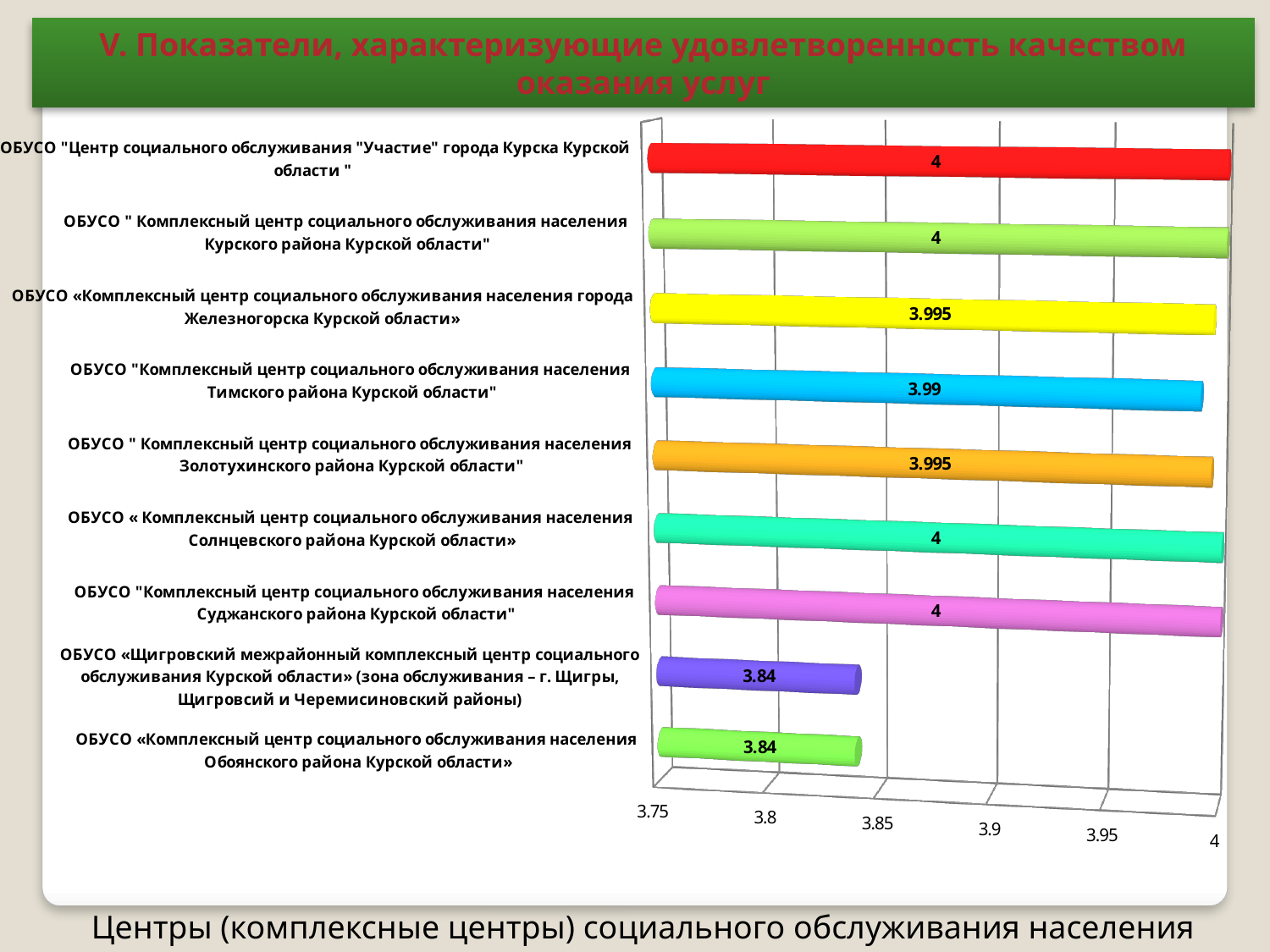
What kind of chart is shown on the slide? bar chart What is the difference between the value for the Тимского района centre and the value for the Щигровский межрайонный centre? 0.15 Which has the larger value: the Золотухинского района centre or the Тимского района centre? Золотухинского района centre What is the value for ОБУСО "Комплексный центр социального обслуживания населения Суджанского района Курской области"? 4 How many centres (categories) are plotted in the chart? 9 What is the value for ОБУСО "Комплексный центр социального обслуживания населения Тимского района Курской области"? 3.99 Is the value for the Щигровский межрайонный centre greater or less than 3.9? less What is the caption text shown below the chart? Центры (комплексные центры) социального обслуживания населения What is the value for ОБУСО «Комплексный центр социального обслуживания населения Обоянского района Курской области»? 3.84 What is the highest value shown in the chart? 4 What is the lowest value shown in the chart? 3.84 What is the value for ОБУСО «Комплексный центр социального обслуживания населения города Железногорска Курской области»? 3.995